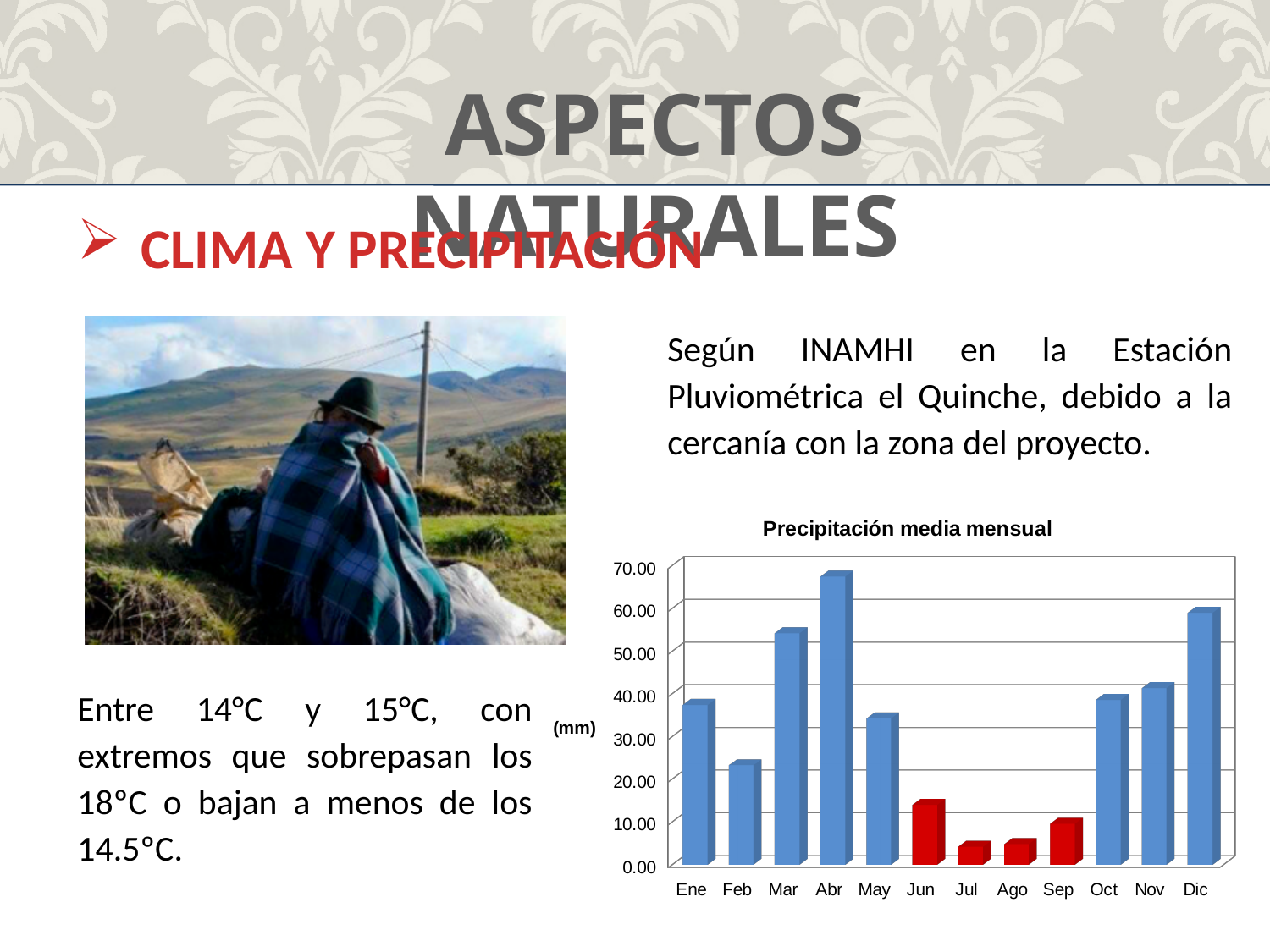
What is the title of the chart on the slide? Precipitación media mensual Is the precipitation value for May greater or less than 40.00? less Do the precipitation values rise or fall from Abr to Jul? fall Is the precipitation value for Mar greater or less than 50.00? greater What kind of chart is used to show the monthly precipitation? Bar chart Is the precipitation value for Feb greater or less than 20.00? greater Which months are shown with red bars in the precipitation chart? Jun, Jul, Ago, Sep Which month has higher precipitation, Ene or Feb? Ene How many months are shown on the x axis of the precipitation chart? 12 Which month has the highest precipitation in the chart? Abr